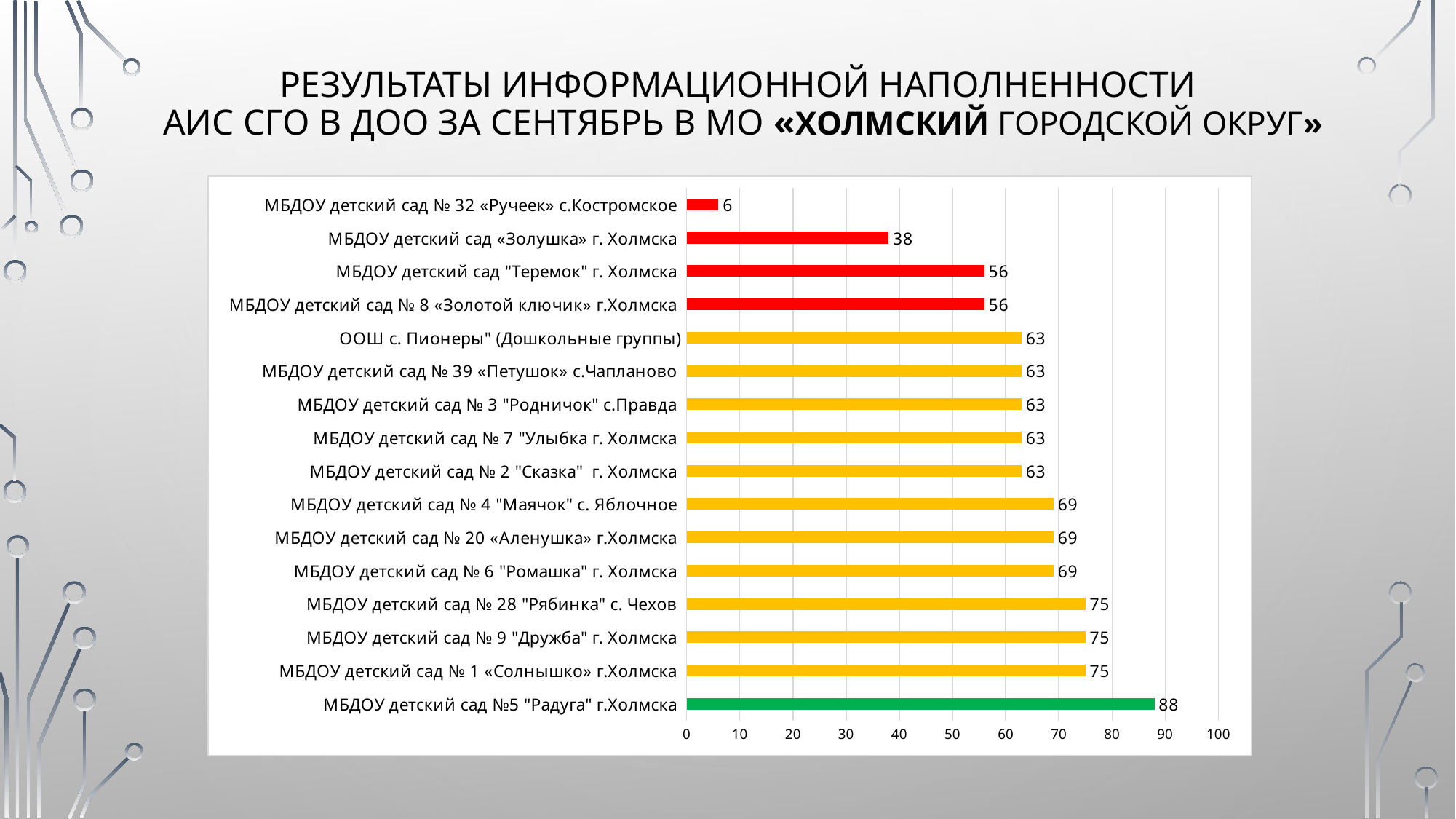
How many categories are shown in the chart? 16 Which category has the lowest value? МБДОУ детский сад № 32 «Ручеек» с.Костромское Which is larger: the value for МБДОУ детский сад "Теремок" г. Холмска or the value for МБДОУ детский сад № 28 "Рябинка" с. Чехов? МБДОУ детский сад № 28 "Рябинка" с. Чехов What is the value for МБДОУ детский сад № 32 «Ручеек» с.Костромское? 6 Which category has the highest value? МБДОУ детский сад №5 "Радуга" г.Холмска Is the value for МБДОУ детский сад «Золушка» г. Холмска greater or less than 50? less What colour is the bar for МБДОУ детский сад №5 "Радуга" г.Холмска? green What is the difference between the values for МБДОУ детский сад №5 "Радуга" г.Холмска and МБДОУ детский сад № 1 «Солнышко» г.Холмска? 13 What kind of chart is shown on the slide? bar chart What is the value for МБДОУ детский сад № 4 "Маячок" с. Яблочное? 69 What is the value for МБДОУ детский сад «Золушка» г. Холмска? 38 What is the value for МБДОУ детский сад №5 "Радуга" г.Холмска? 88